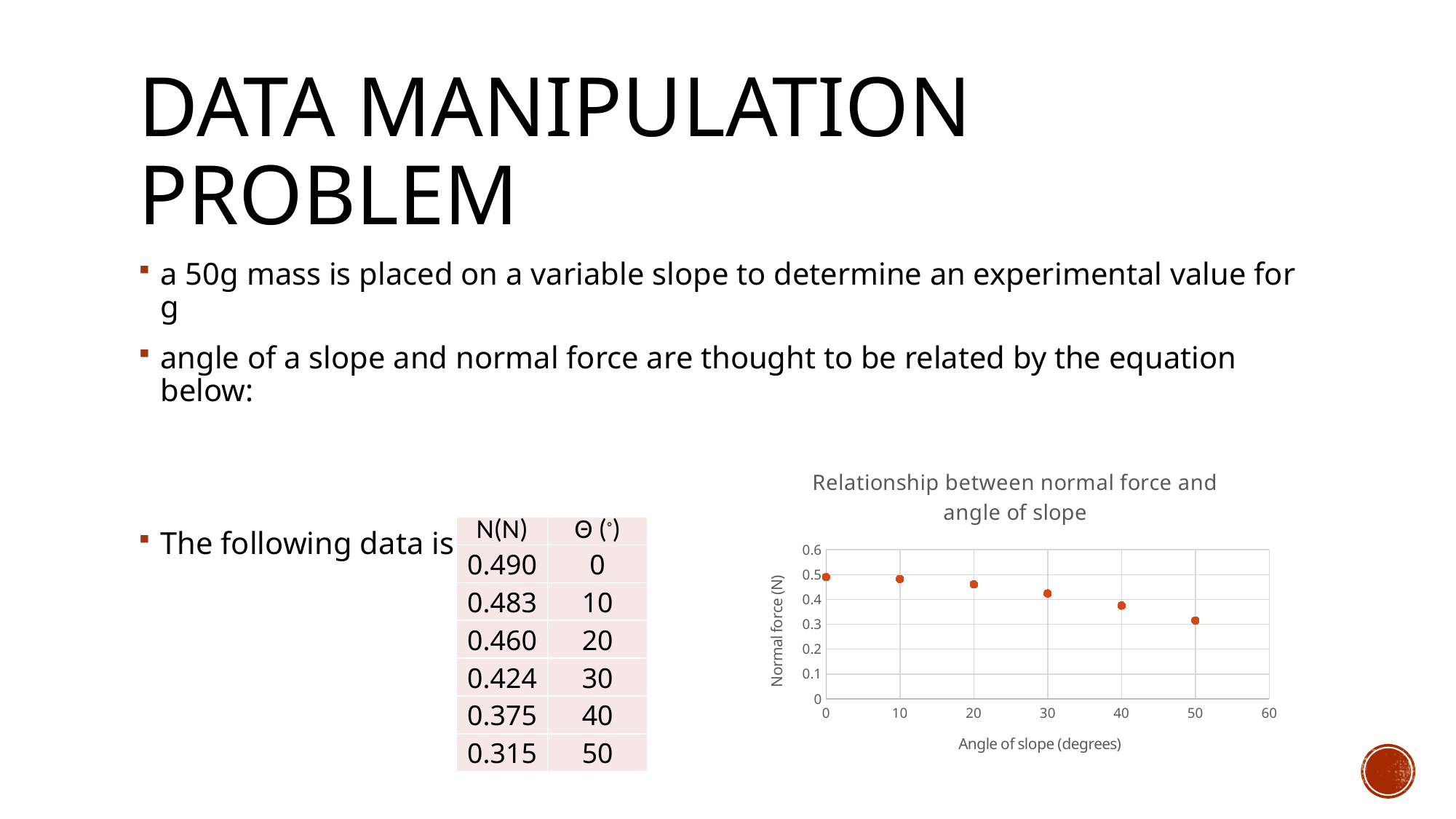
What is the label of the y axis of the chart? Normal force (N) According to the slide, what is the normal force at an angle of slope of 50 degrees? 0.315 At which angle of slope is the normal force lowest? 50 What is the title of the chart? Relationship between normal force and angle of slope According to the slide, what is the normal force at an angle of slope of 30 degrees? 0.424 Does the normal force rise or fall as the angle of slope increases? fall According to the slide, what is the normal force at an angle of slope of 0 degrees? 0.490 Is the normal force at 40 degrees greater or less than 0.4? less How many data points are plotted on the chart? 6 What kind of chart is shown on the slide? scatter chart At which angle of slope is the normal force highest? 0 What is the difference between the normal force at 0 degrees and at 50 degrees? 0.175